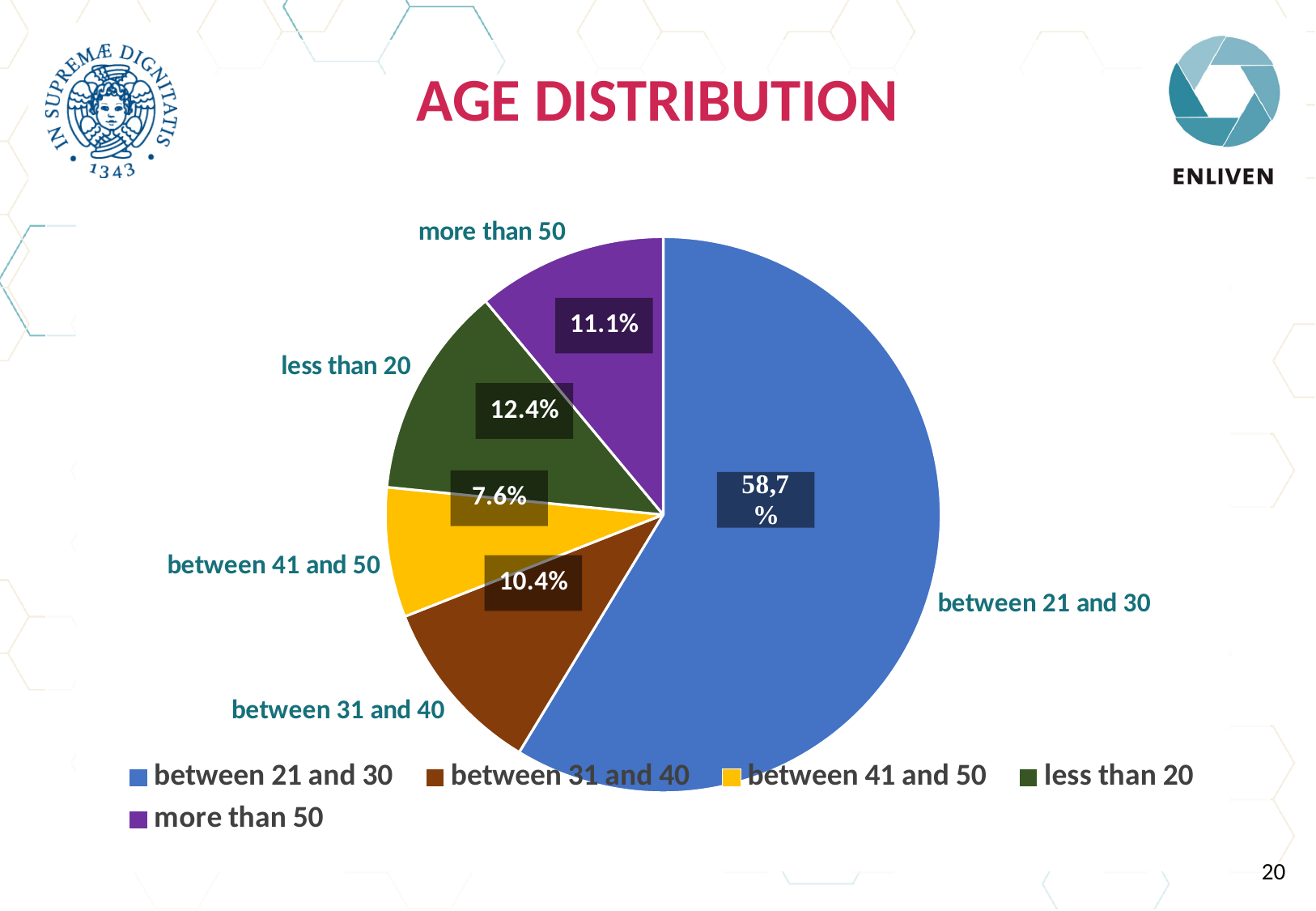
What colour is the 'between 41 and 50' slice? yellow Which slice is larger, 'less than 20' or 'between 31 and 40'? less than 20 Which age group has the smallest share of the pie? between 41 and 50 What percentage is shown for the 'between 41 and 50' slice? 7.6% What is the title of the chart? AGE DISTRIBUTION What is the difference in percentage points between the 'between 31 and 40' slice and the 'between 41 and 50' slice? 2.8% How many slices does the pie chart have? 5 What kind of chart is shown on the slide? pie chart What percentage is shown for the 'more than 50' slice? 11.1% Which age group has the largest share of the pie? between 21 and 30 What percentage is shown for the 'between 21 and 30' slice? 58,7% What percentage is shown for the 'less than 20' slice? 12.4%